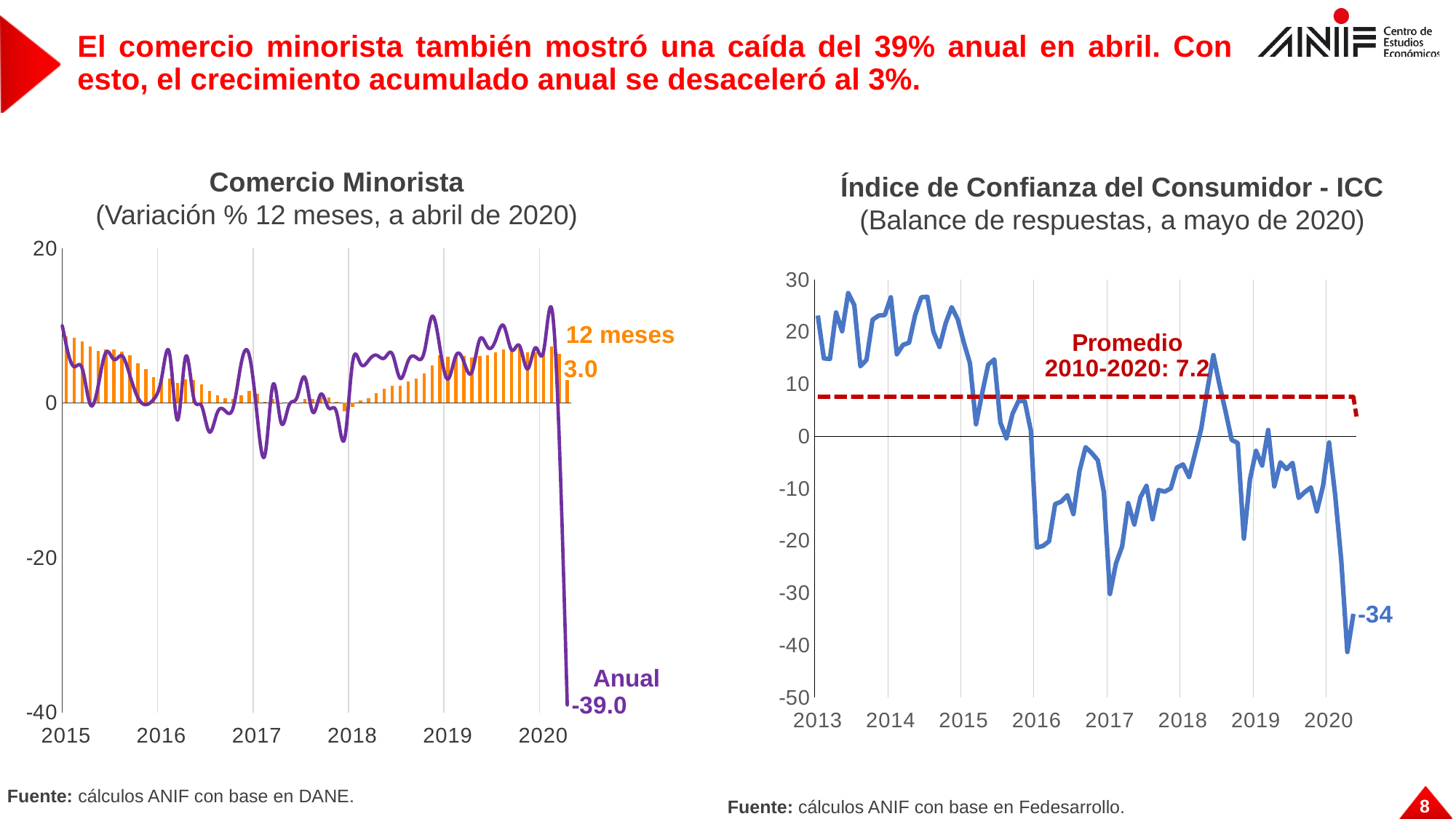
In the Índice de Confianza del Consumidor - ICC chart, what is the latest value of the index? -34 What kind of chart is the Índice de Confianza del Consumidor - ICC chart? line chart In the Comercio Minorista chart, does the Anual series rise or fall in 2020? fall In the Comercio Minorista chart, what is the difference between the latest 12 meses value and the latest Anual value? 42.0 In the Índice de Confianza del Consumidor - ICC chart, is the lowest value reached in 2017 greater or less than -20? less In the Comercio Minorista chart, which series has the larger latest value, 12 meses or Anual? 12 meses In the Comercio Minorista chart, what colour are the 12 meses bars? orange In the Comercio Minorista chart, what is the latest value of the 12 meses series? 3.0 In the Comercio Minorista chart, what is the latest value of the Anual series? -39.0 How many series are labelled in the Comercio Minorista chart? 2 In the Índice de Confianza del Consumidor - ICC chart, what is the Promedio 2010-2020 value? 7.2 In the Índice de Confianza del Consumidor - ICC chart, is the value at the start of 2016 greater or less than -10? less